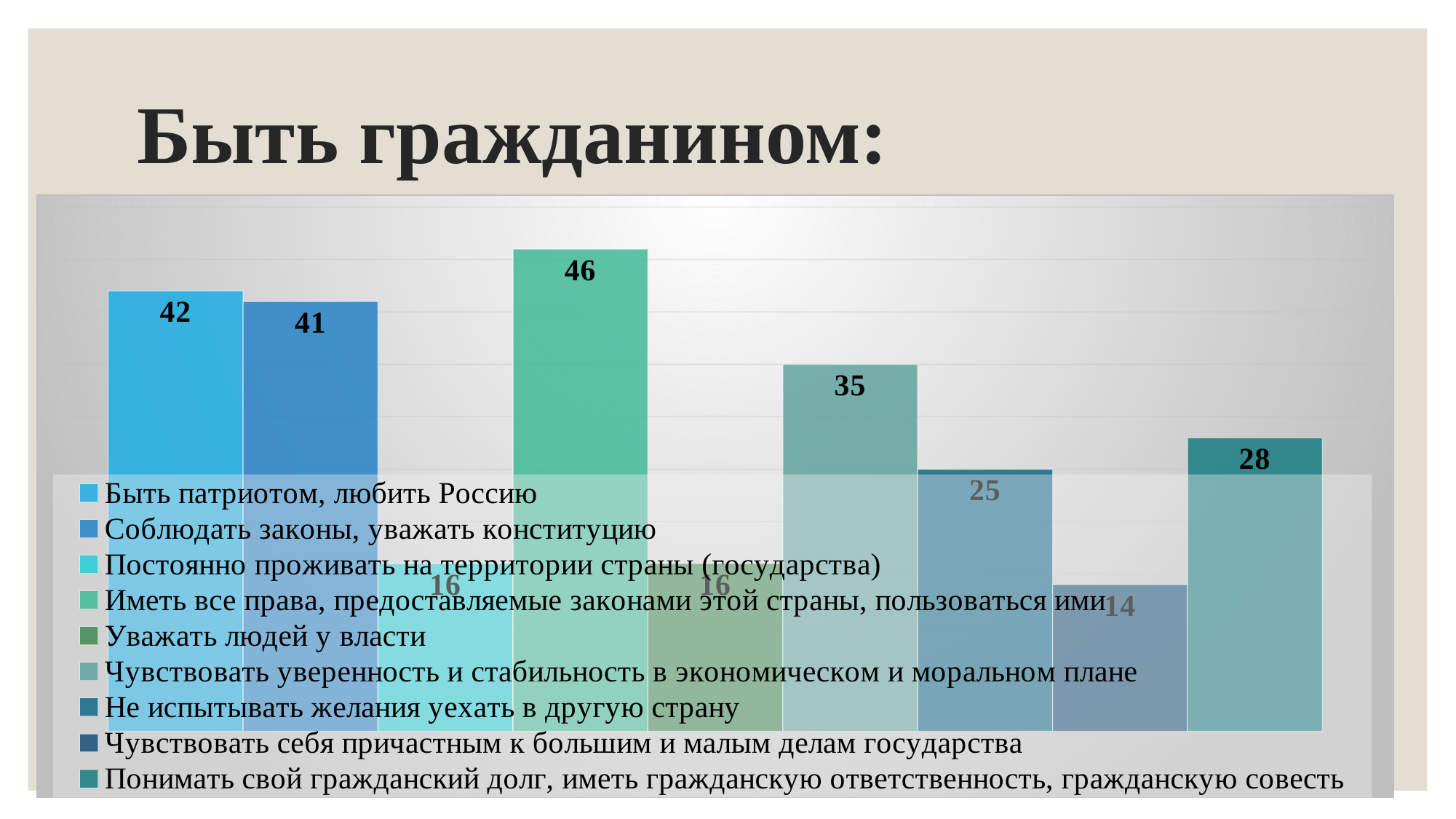
Which legend entry has the highest value? Иметь все права, предоставляемые законами этой страны, пользоваться ими How many bars are plotted on the chart? 9 What value is shown for "Соблюдать законы, уважать конституцию"? 41 Which is larger: the value for "Не испытывать желания уехать в другую страну" or for "Понимать свой гражданский долг, иметь гражданскую ответственность, гражданскую совесть"? Понимать свой гражданский долг, иметь гражданскую ответственность, гражданскую совесть What value is shown for "Быть патриотом, любить Россию"? 42 What value is shown for "Понимать свой гражданский долг, иметь гражданскую ответственность, гражданскую совесть"? 28 What kind of chart is shown on the slide? bar chart What value is shown for "Иметь все права, предоставляемые законами этой страны, пользоваться ими"? 46 Which legend entry has the lowest value? Чувствовать себя причастным к большим и малым делам государства What is the title of the slide? Быть гражданином: What is the difference between the values for "Иметь все права, предоставляемые законами этой страны, пользоваться ими" and "Чувствовать уверенность и стабильность в экономическом и моральном плане"? 11 How many entries does the legend list? 9